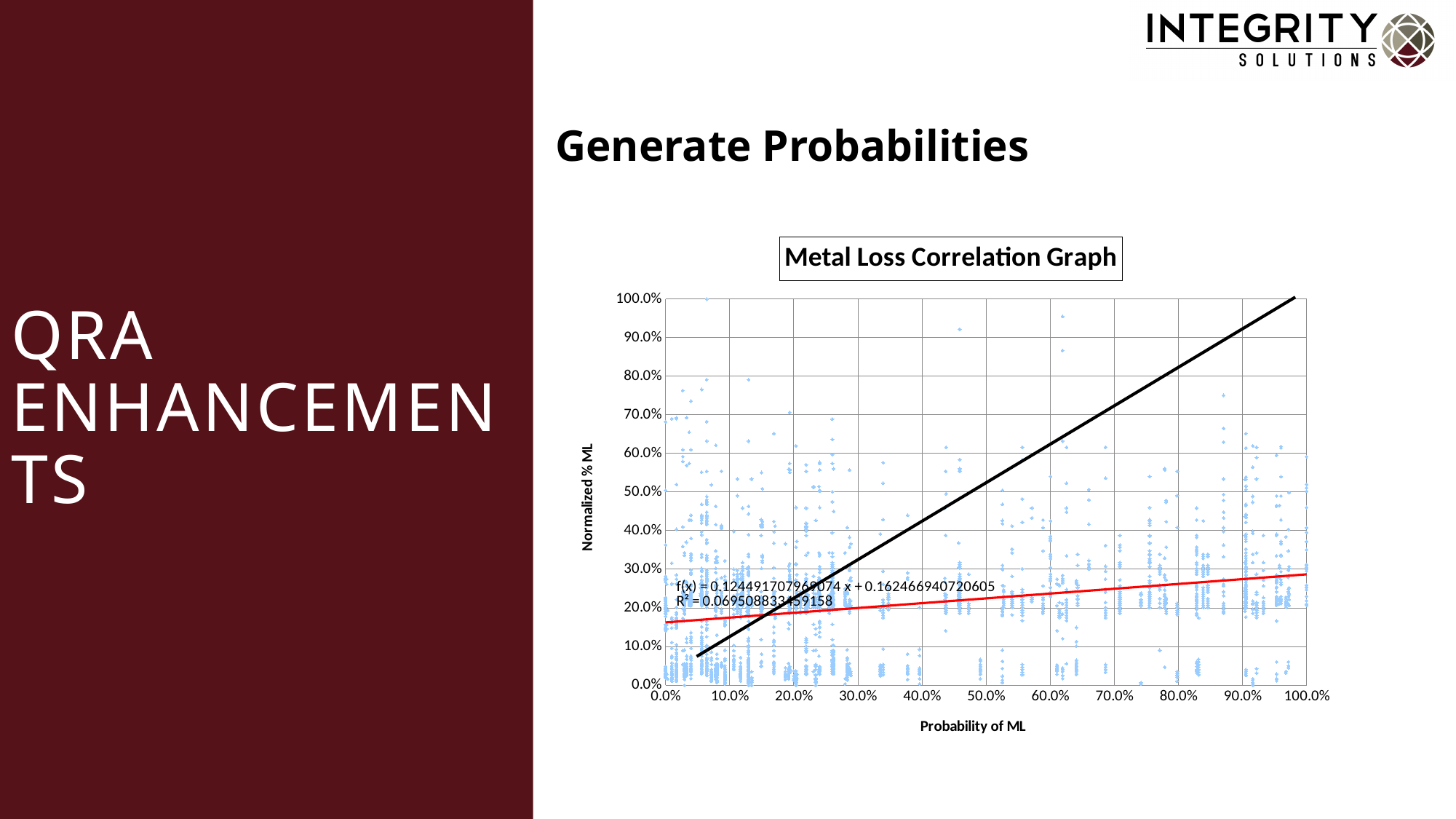
Is the value of the red trendline at 0.0% Probability of ML greater or less than 20.0%? less What is the intercept of the trendline equation printed on the chart? 0.162466940720605 What is the R² value printed on the chart? 0.069508833459158 Is the value of the black line at 100.0% Probability of ML greater or less than 90.0%? greater What kind of chart is shown on the slide? Scatter chart What is the slope of the trendline equation printed on the chart? 0.124491707969074 What is the label of the x axis of the chart? Probability of ML What is the title of the chart? Metal Loss Correlation Graph Does the red trendline rise or fall as Probability of ML increases? Rises What is the maximum value shown on the y axis of the chart? 100.0% What is the trendline equation printed on the chart? f(x) = 0.124491707969074 x + 0.162466940720605 Is the value of the red trendline at 0.0% Probability of ML greater or less than 10.0%? greater